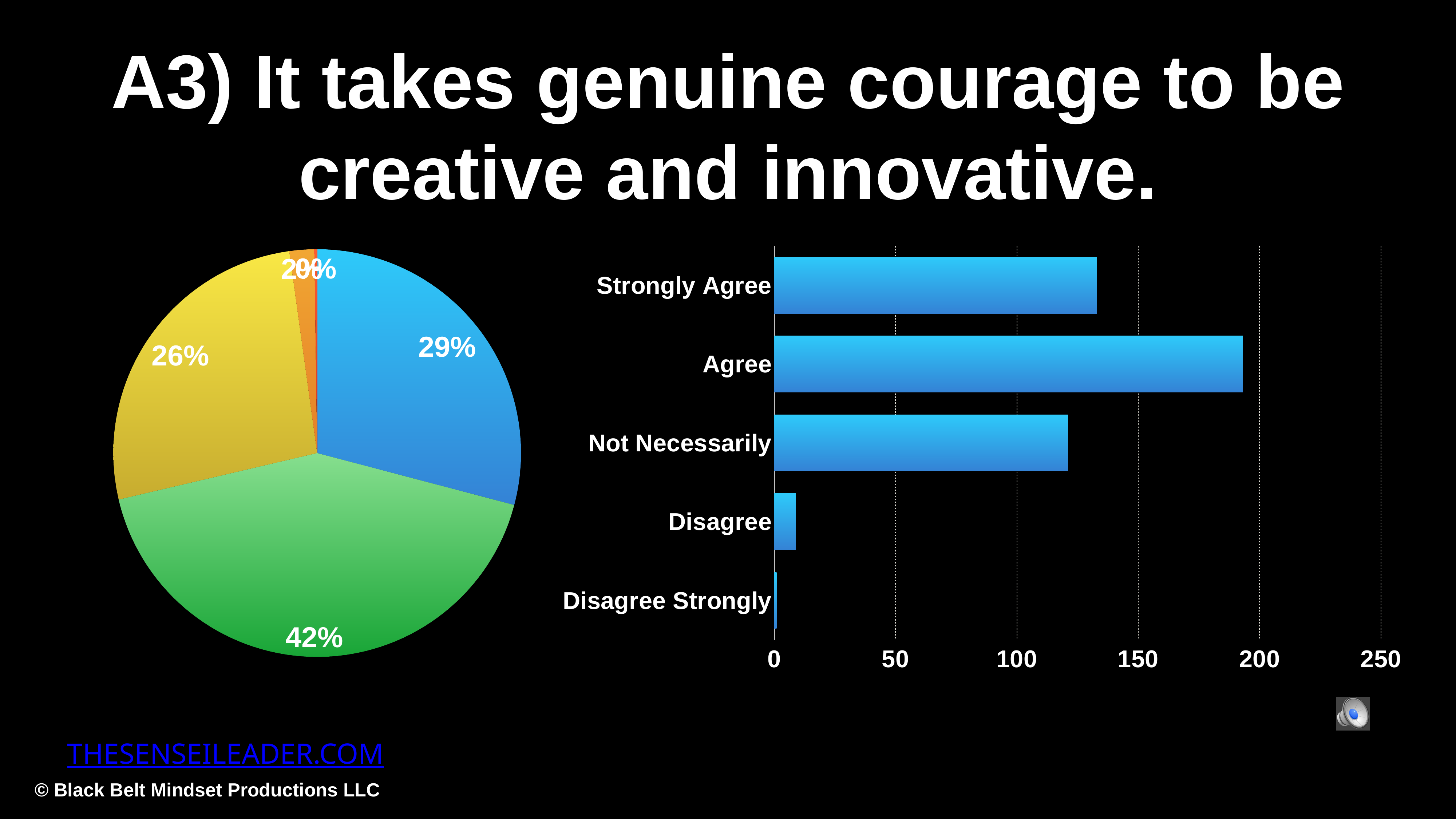
What kind of chart is the chart on the left of the slide? pie chart In the bar chart on the right, is the value for Not Necessarily greater or less than 100? greater In the bar chart on the right, is the value for Strongly Agree greater or less than 150? less In the bar chart on the right, is the value for Agree greater or less than 150? greater How many categories does the bar chart on the right show? 5 In the bar chart on the right, which category has the highest value? Agree What kind of chart is the chart on the right of the slide? bar chart In the pie chart on the left, what is the share of the largest slice? 42% In the bar chart on the right, which is larger, the value for Agree or the value for Strongly Agree? Agree In the pie chart on the left, what colour is the largest slice? green In the bar chart on the right, which category has the lowest value? Disagree Strongly